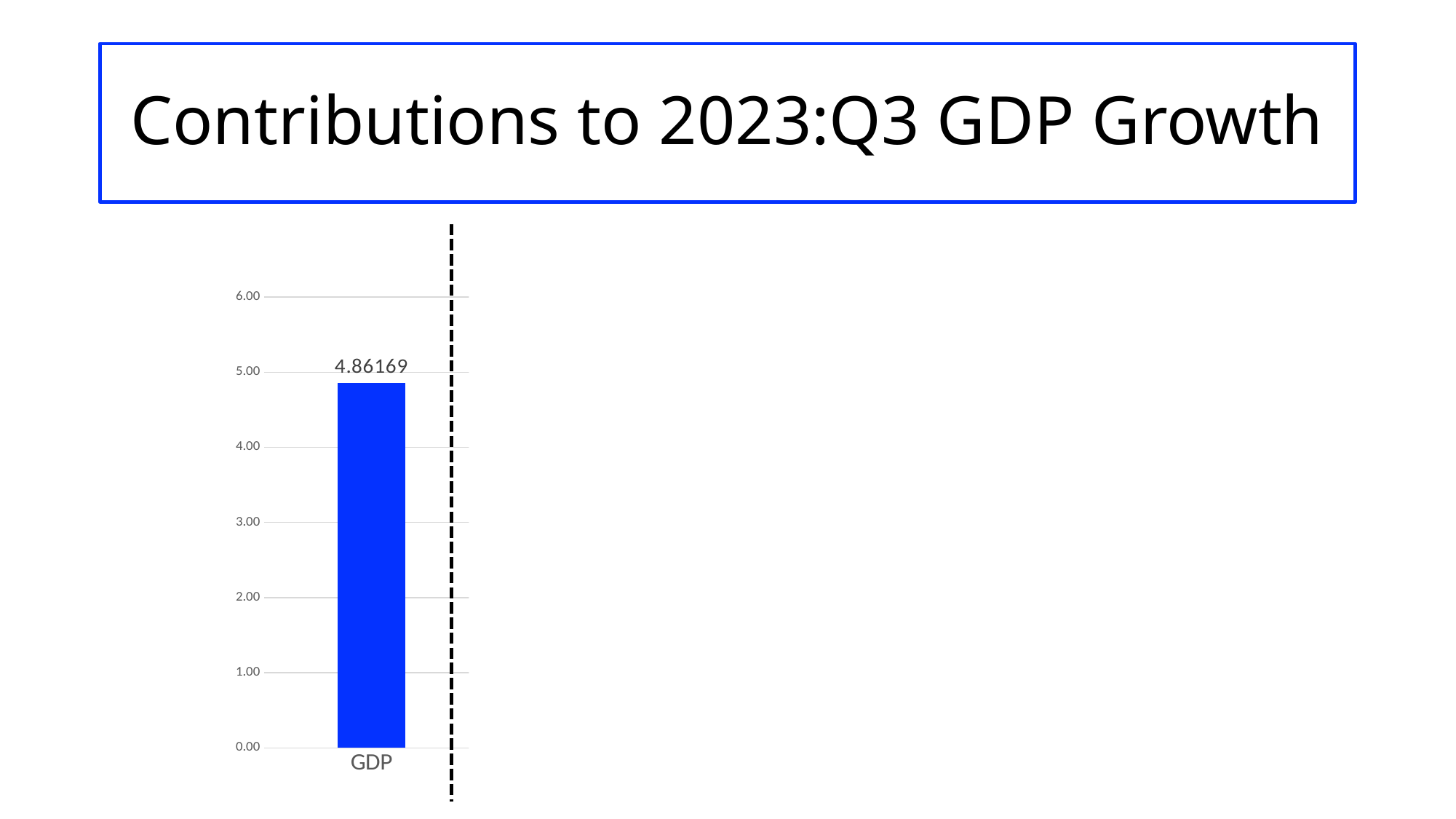
How many bars are plotted on the chart? 1 Is the value for GDP greater or less than 5.00? less What kind of chart is shown on the slide? bar chart Is the value for GDP greater or less than 4.00? greater What colour is the GDP bar? blue What is the highest value shown on the y axis? 6.00 What is the value shown for GDP? 4.86169 What is the label of the category on the x axis? GDP